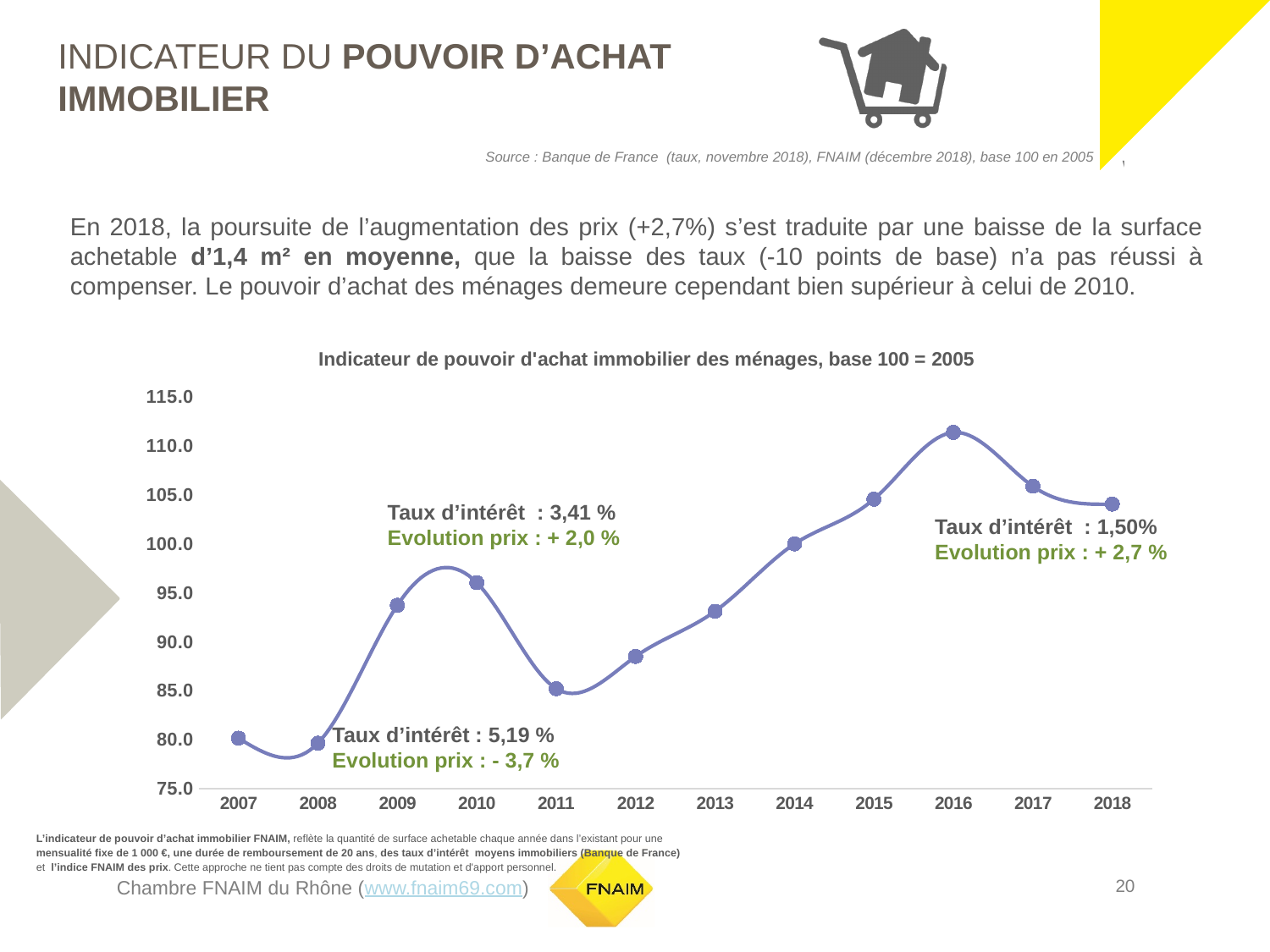
According to the annotation near the 2016-2018 points, what is the interest rate (taux d'intérêt)? 1,50% Is the value for 2018 greater or less than 100? greater How many years are plotted on the x axis of the chart? 12 Which year has the larger value, 2017 or 2013? 2017 Is the value for 2011 greater or less than 90? less Is the value for 2016 greater or less than 110? greater Does the indicator rise or fall between 2014 and 2016? rise What is the title of the chart? Indicateur de pouvoir d'achat immobilier des ménages, base 100 = 2005 Which year has the larger value, 2010 or 2011? 2010 Which year has the highest value of the indicator? 2016 What kind of chart is shown on the slide? line chart